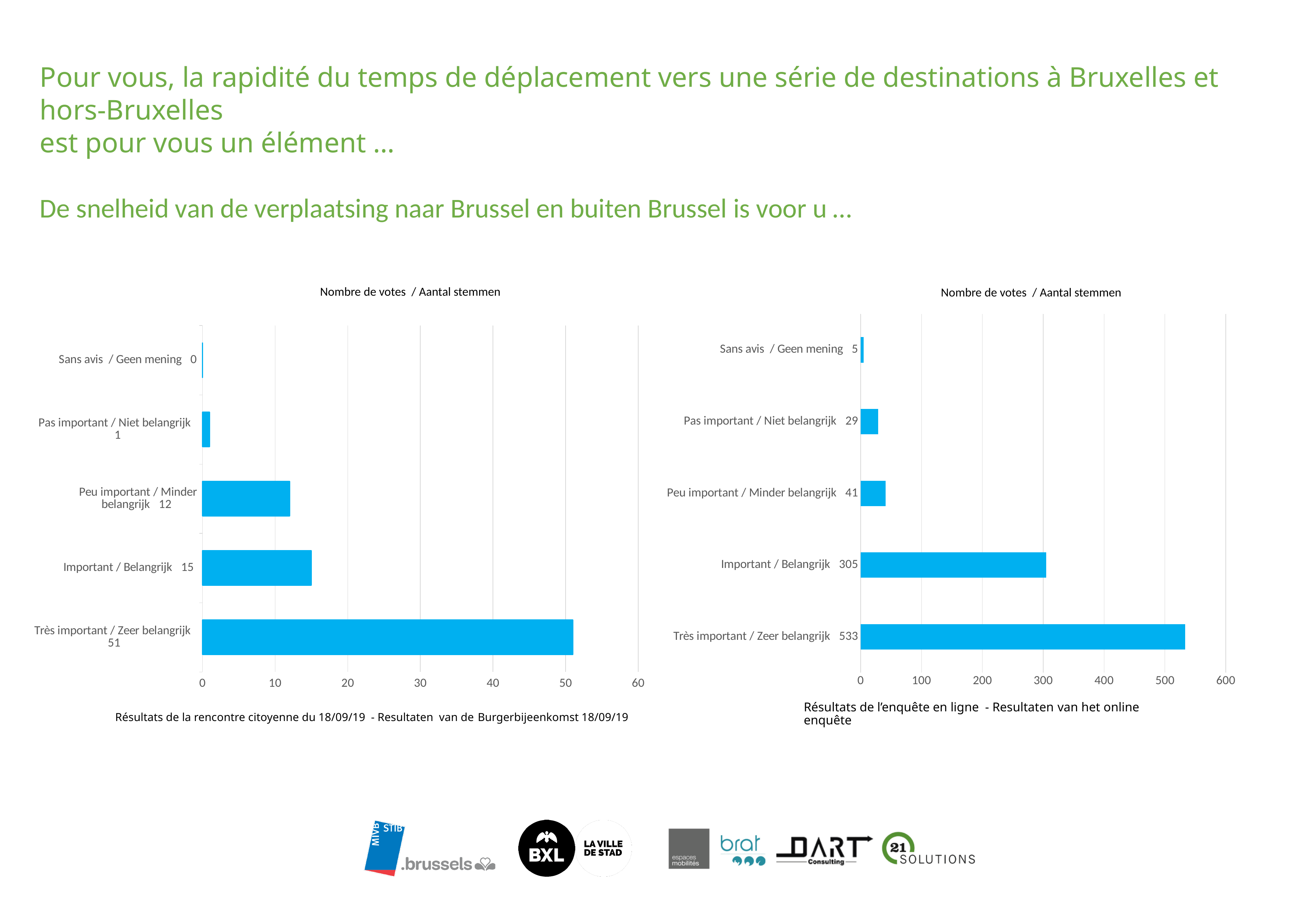
In the left chart (Résultats de la rencontre citoyenne du 18/09/19), which has more votes: 'Important / Belangrijk' or 'Peu important / Minder belangrijk'? Important / Belangrijk How many categories are shown in the left chart (Résultats de la rencontre citoyenne du 18/09/19)? 5 What is the title shown above each of the two charts? Nombre de votes / Aantal stemmen In the right chart (Résultats de l'enquête en ligne), how many votes did 'Important / Belangrijk' receive? 305 In the right chart (Résultats de l'enquête en ligne), which category has the highest number of votes? Très important / Zeer belangrijk In the right chart (Résultats de l'enquête en ligne), is the value for 'Très important / Zeer belangrijk' greater or less than 500? greater In the left chart (Résultats de la rencontre citoyenne du 18/09/19), which category has the lowest number of votes? Sans avis / Geen mening In the right chart (Résultats de l'enquête en ligne), what is the total number of votes across all five categories? 913 In the left chart (Résultats de la rencontre citoyenne du 18/09/19), how many votes did 'Très important / Zeer belangrijk' receive? 51 In the right chart (Résultats de l'enquête en ligne), what is the difference in votes between 'Très important / Zeer belangrijk' and 'Important / Belangrijk'? 228 In the left chart (Résultats de la rencontre citoyenne du 18/09/19), how many votes did 'Pas important / Niet belangrijk' receive? 1 What kind of chart is the right chart (Résultats de l'enquête en ligne)? bar chart